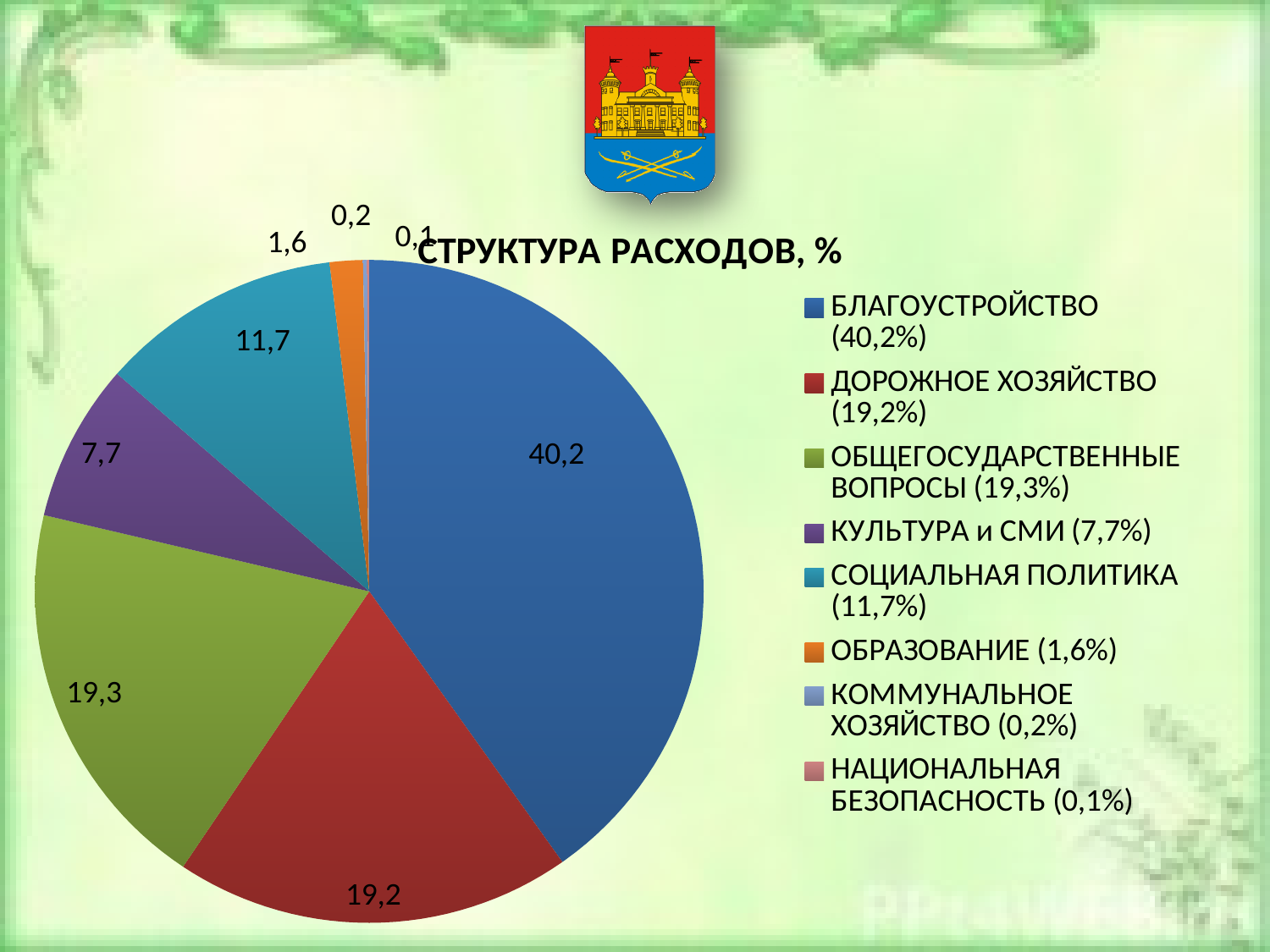
Which is larger, the value for СОЦИАЛЬНАЯ ПОЛИТИКА or the value for КУЛЬТУРА и СМИ? СОЦИАЛЬНАЯ ПОЛИТИКА Which category has the largest slice of the pie? БЛАГОУСТРОЙСТВО What is the value for КУЛЬТУРА и СМИ? 7,7 What share of the pie does ОБЩЕГОСУДАРСТВЕННЫЕ ВОПРОСЫ represent? 19,3% What is the difference between the values for БЛАГОУСТРОЙСТВО and ДОРОЖНОЕ ХОЗЯЙСТВО? 21,0 Which category has the smallest slice of the pie? НАЦИОНАЛЬНАЯ БЕЗОПАСНОСТЬ What is the title of the chart? СТРУКТУРА РАСХОДОВ, % What type of chart is shown on the slide? pie chart What is the value for ОБРАЗОВАНИЕ? 1,6 How many categories are shown in the pie chart? 8 What is the value for БЛАГОУСТРОЙСТВО? 40,2 What is the value for СОЦИАЛЬНАЯ ПОЛИТИКА? 11,7